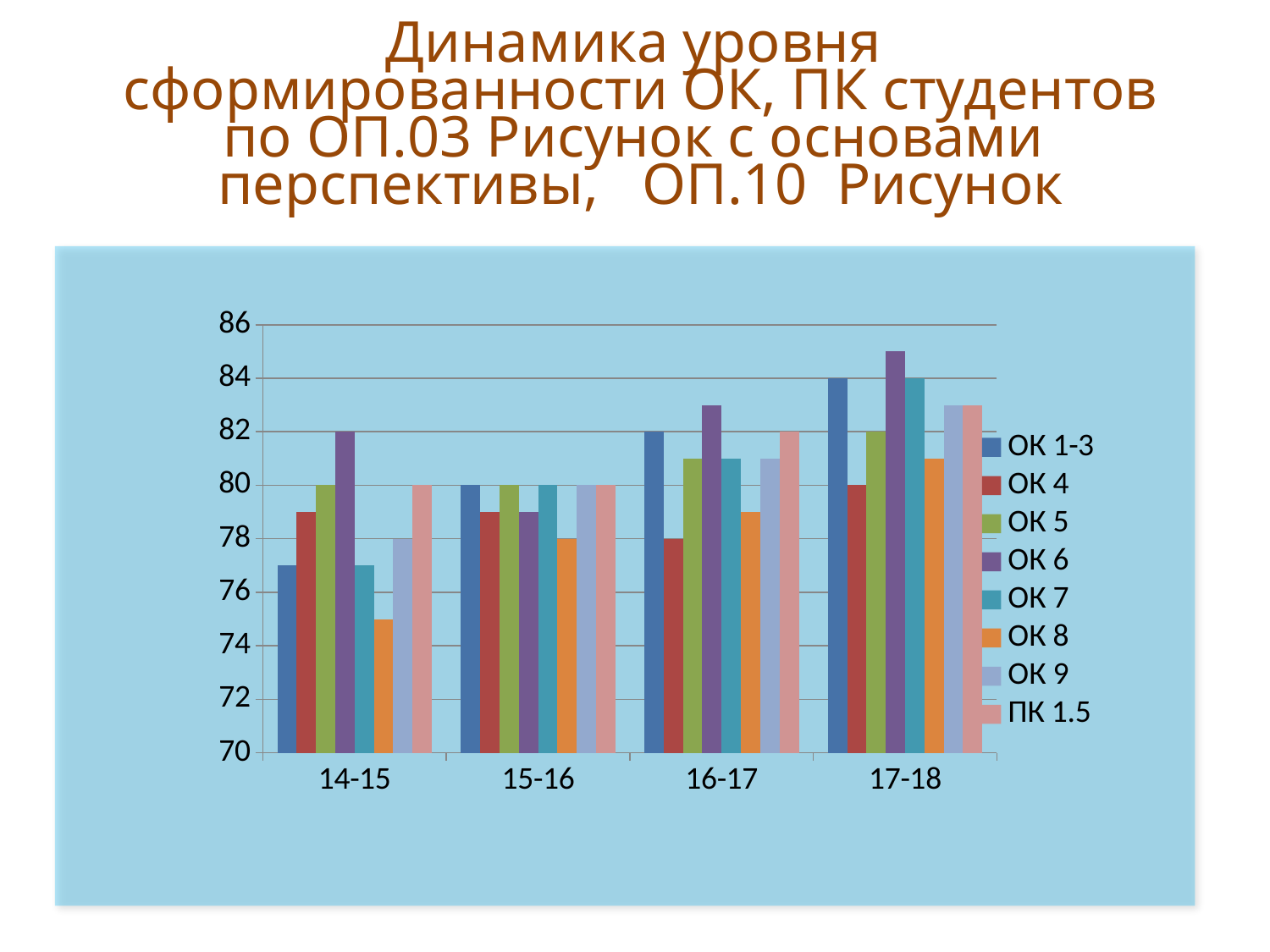
What is the value for ОК 1-3 in 17-18? 84 Do the values for ОК 1-3 rise or fall from 14-15 to 17-18? rise Which series has the highest bar in 17-18? ОК 6 Is the value for ОК 8 in 14-15 greater or less than 76? less How many series does the legend list? 8 What is the value for ОК 1-3 in 15-16? 80 What kind of chart is shown on the slide? bar chart Is the value for ОК 6 in 17-18 greater or less than 84? greater What is the value for ОК 6 in 14-15? 82 How many year categories are shown on the x axis? 4 Which is larger in 16-17: ОК 1-3 or ОК 4? ОК 1-3 Which series has the lowest bar in 14-15? ОК 8